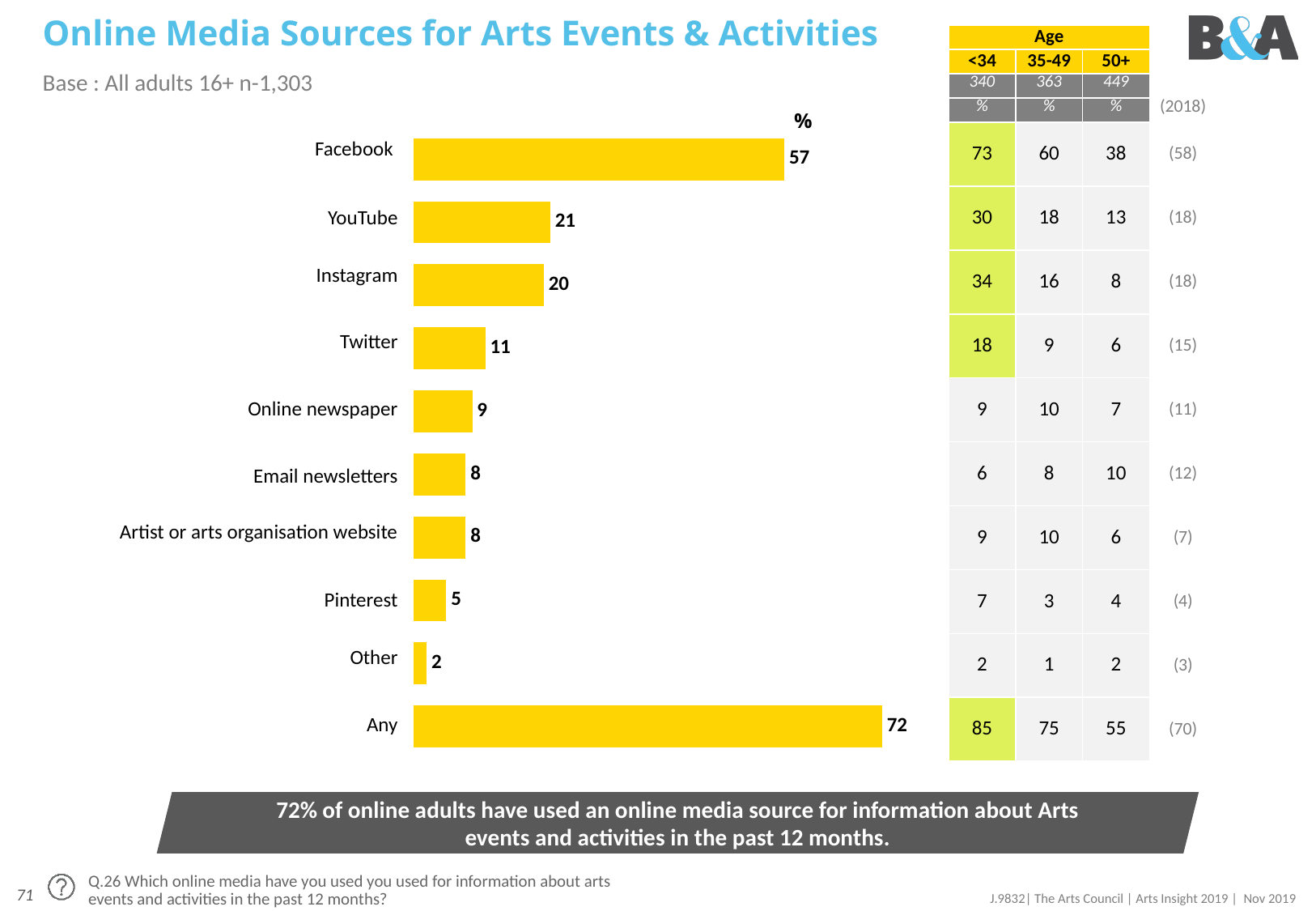
What is the difference between the values for Twitter and Online newspaper? 2 Which has a higher value, Instagram or Pinterest? Instagram What is the difference between the values for Facebook and YouTube? 36 Which category has the longest bar in the chart? Any What is the value shown for Facebook in the bar chart? 57 What type of chart is shown on the slide? Bar chart Which has a higher value, YouTube or Twitter? YouTube What is the value shown for Pinterest in the bar chart? 5 How many categories are plotted in the bar chart? 10 What is the value shown for Instagram in the bar chart? 20 Which category has the shortest bar in the chart? Other What is the title of the slide's chart? Online Media Sources for Arts Events & Activities